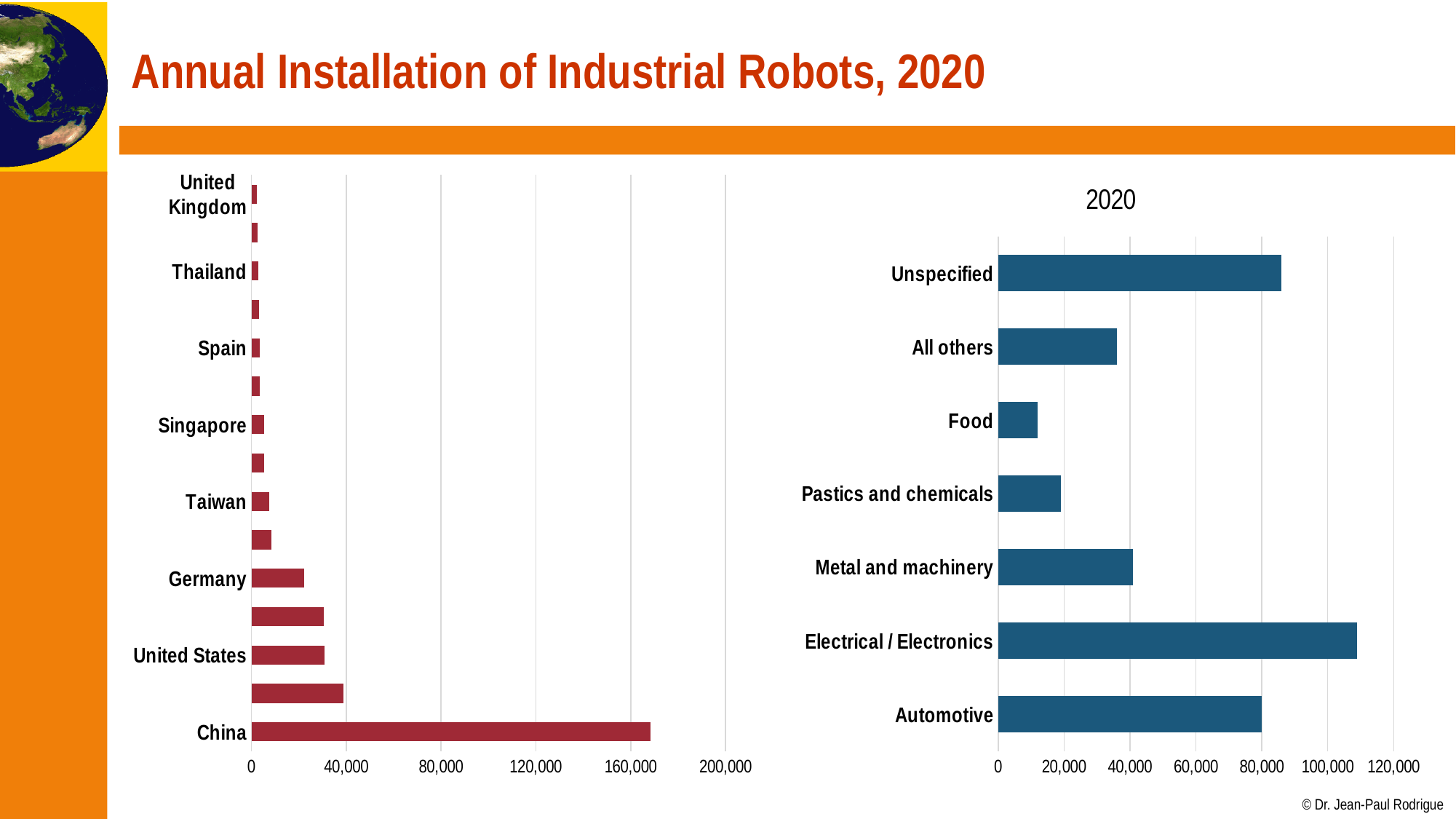
In the left chart, which country has the highest value? China In the right chart titled "2020", which category has the lowest value? Food In the left chart, is the value for China greater or less than 160,000? greater In the right chart titled "2020", how many categories are shown? 7 In the right chart titled "2020", which is larger, the value for Food or the value for Pastics and chemicals? Pastics and chemicals In the right chart titled "2020", which category has the highest value? Electrical / Electronics In the left chart, is the value for United States greater or less than 40,000? less In the right chart titled "2020", is the value for Unspecified greater or less than 80,000? greater What kind of chart is the right chart titled "2020"? bar chart What kind of chart is the left chart showing countries? bar chart In the left chart, which is larger, the value for Germany or the value for United States? United States